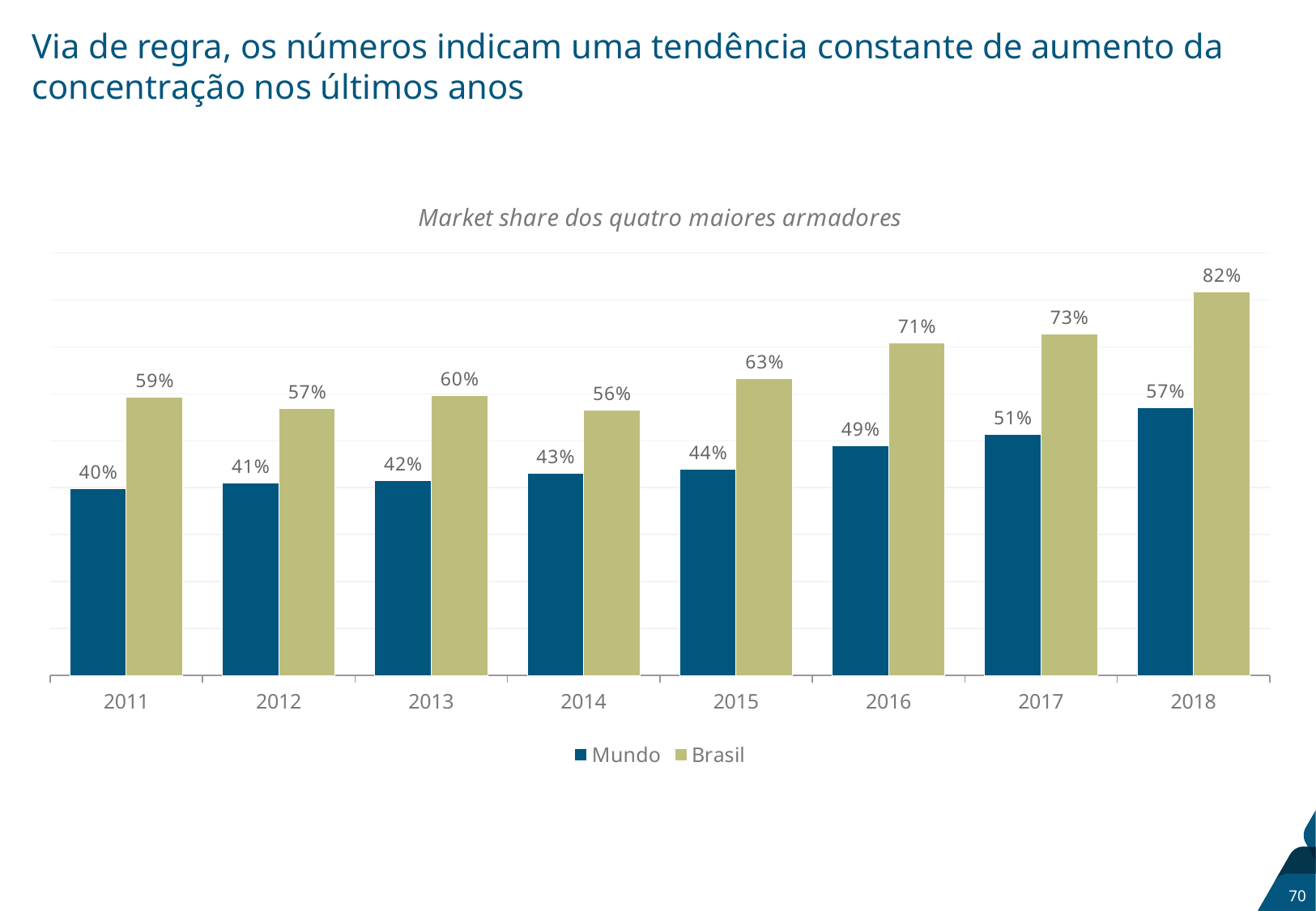
What kind of chart is shown on the slide? Bar chart What is the difference between the Brasil and Mundo values in 2018? 25% What is the value for Brasil in 2014? 56% What is the value for Brasil in 2018? 82% How many years are shown on the x axis? 8 In which year is the Brasil value highest? 2018 Do the Mundo values rise or fall from 2011 to 2018? Rise Which is larger in 2016, the Mundo value or the Brasil value? Brasil What is the value for Mundo in 2011? 40% How many series does the legend list? 2 In which year is the Brasil value lowest? 2014 What is the title of the chart? Market share dos quatro maiores armadores